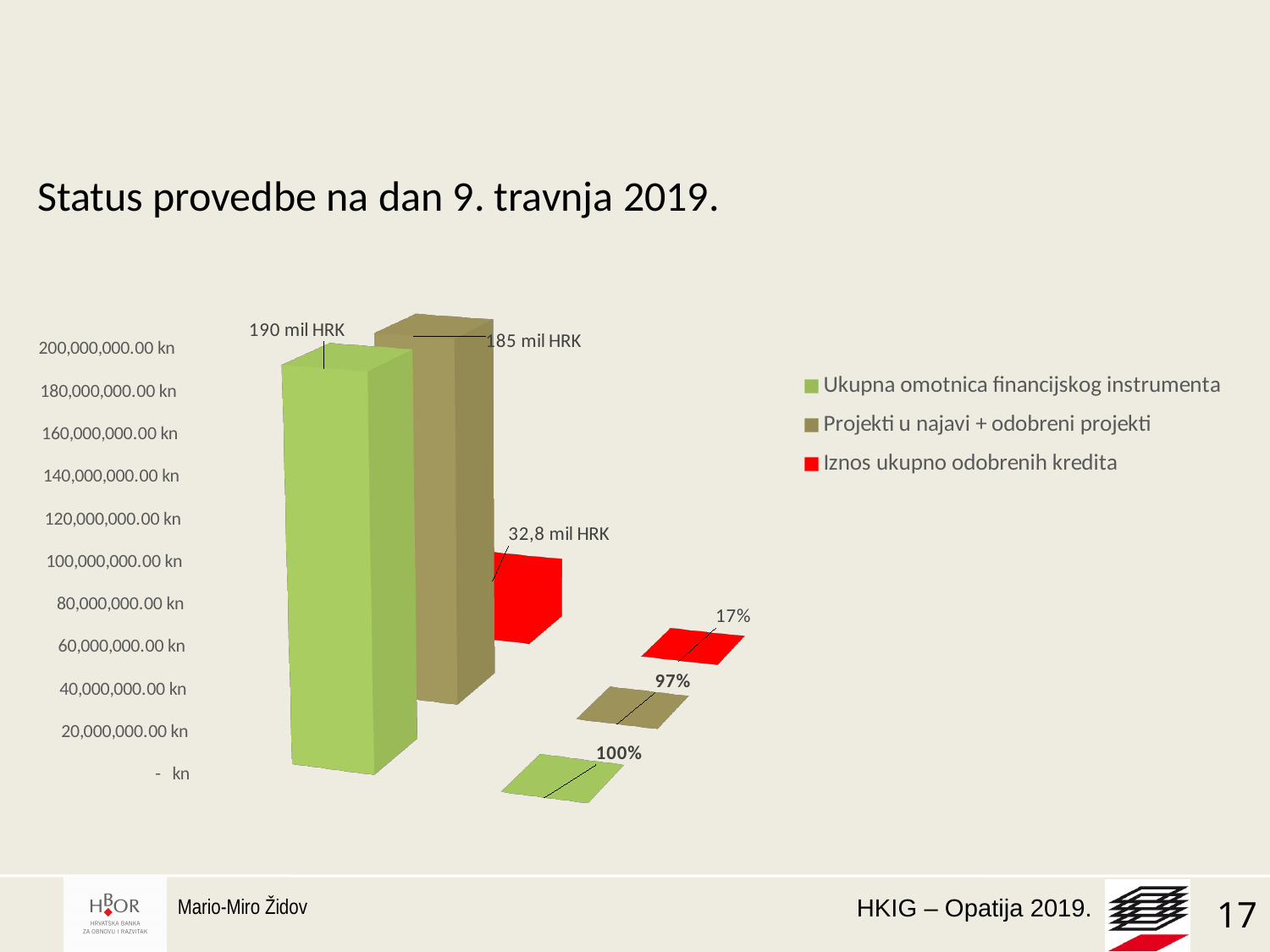
Is the value for Iznos ukupno odobrenih kredita greater or less than 40,000,000.00 kn? less Which is larger: the amount for Projekti u najavi + odobreni projekti or the amount for Iznos ukupno odobrenih kredita? Projekti u najavi + odobreni projekti What percentage is shown for Projekti u najavi + odobreni projekti? 97% What value is labelled on the bar for Projekti u najavi + odobreni projekti? 185 mil HRK Which series has the highest amount in HRK? Ukupna omotnica financijskog instrumenta What percentage is shown for Iznos ukupno odobrenih kredita? 17% Which series has the lowest amount in HRK? Iznos ukupno odobrenih kredita What value is labelled on the bar for Ukupna omotnica financijskog instrumenta? 190 mil HRK What is the difference between the labelled amounts for Ukupna omotnica financijskog instrumenta and Projekti u najavi + odobreni projekti? 5 mil HRK What value is labelled on the bar for Iznos ukupno odobrenih kredita? 32,8 mil HRK How many series does the legend list? 3 What colour represents Iznos ukupno odobrenih kredita in the legend? Red